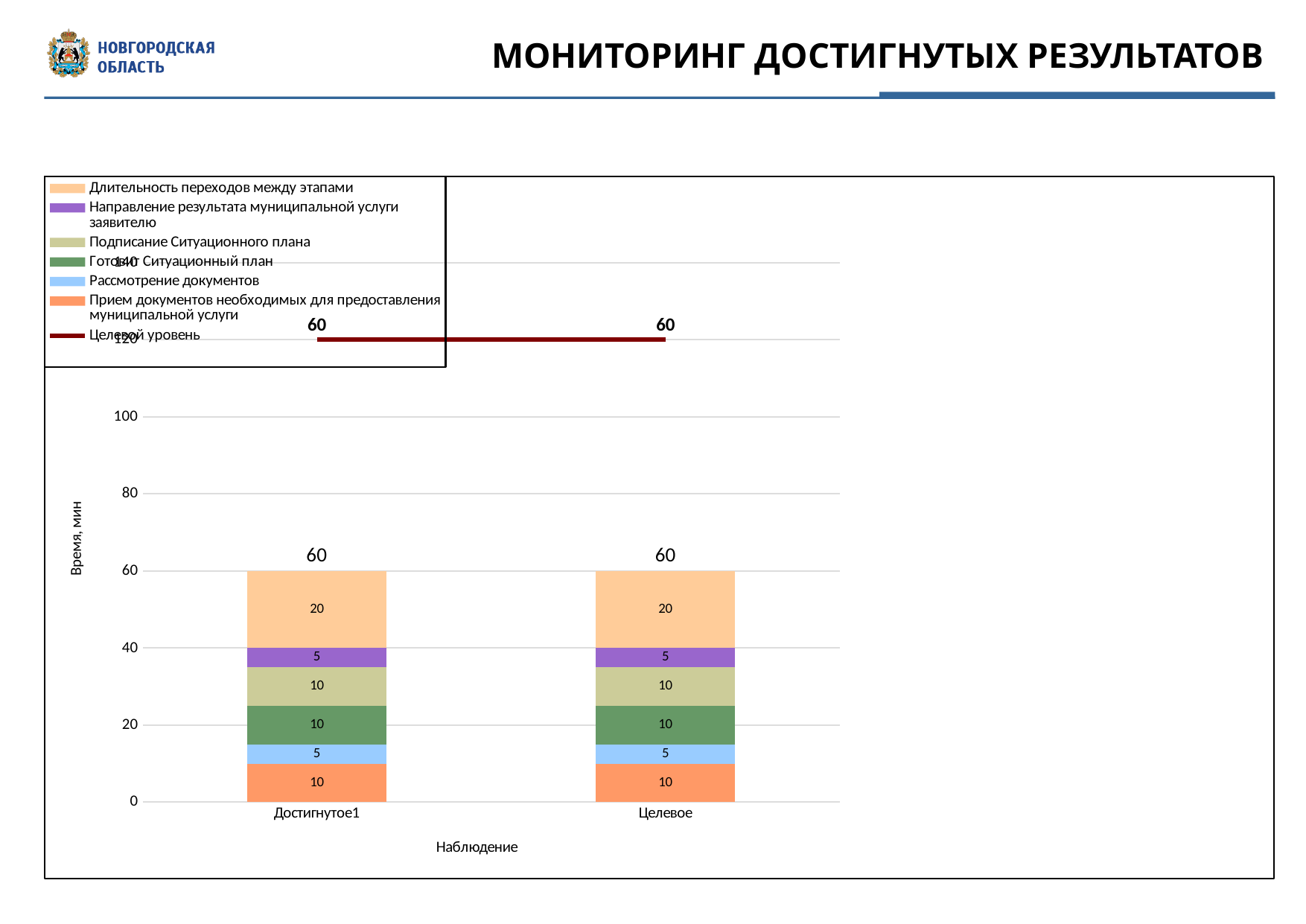
How many categories are shown on the x axis of the chart? 2 What is the difference between the Длительность переходов между этапами segment and the Подписание Ситуационного плана segment for Достигнутое1? 10 What is the label of the y axis of the chart? Время, мин What kind of chart is shown on the slide? combination stacked bar and line chart What is the value of the Длительность переходов между этапами segment for Целевое? 20 What is the total of the stacked bar for Достигнутое1? 60 How many entries does the chart legend list? 7 What is the value of the Прием документов необходимых для предоставления муниципальной услуги segment for Достигнутое1? 10 What is the total of the stacked bar for Целевое? 60 What is the label of the x axis of the chart? Наблюдение What is the value of the Направление результата муниципальной услуги заявителю segment for Целевое? 5 What is the value of the Рассмотрение документов segment for Достигнутое1? 5